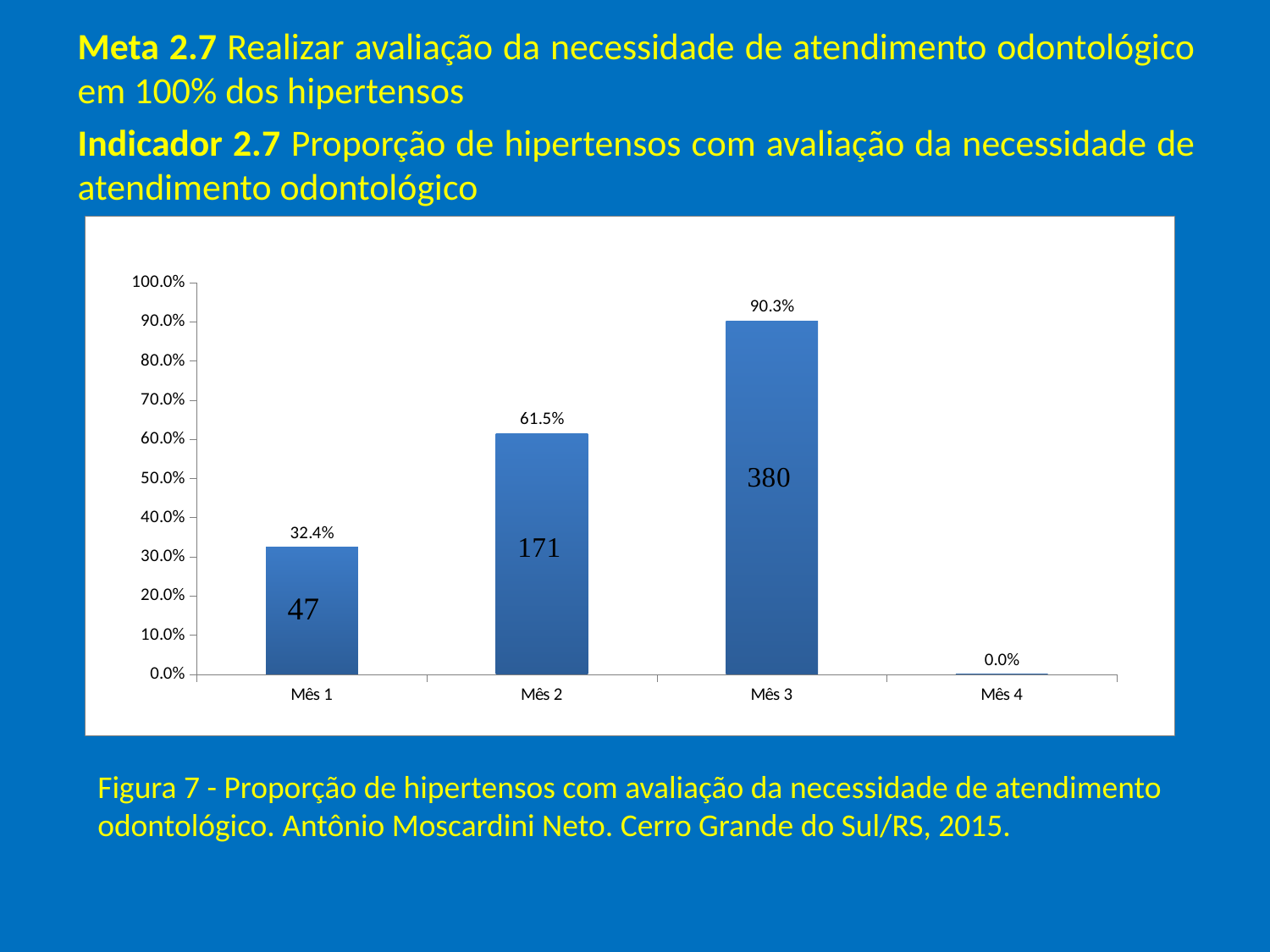
What is the value for Mês 1? 32.4% How many months are shown on the x axis? 4 What is the value for Mês 3? 90.3% What is the value for Mês 4? 0.0% What number is printed inside the bar for Mês 3? 380 What is the value for Mês 2? 61.5% Which is larger, the value for Mês 1 or the value for Mês 2? Mês 2 What is the difference between the values for Mês 3 and Mês 2? 28.8% Which month has the highest value? Mês 3 Which month has the lowest value? Mês 4 Is the value for Mês 2 greater or less than 50.0%? greater What kind of chart is shown on the slide? bar chart